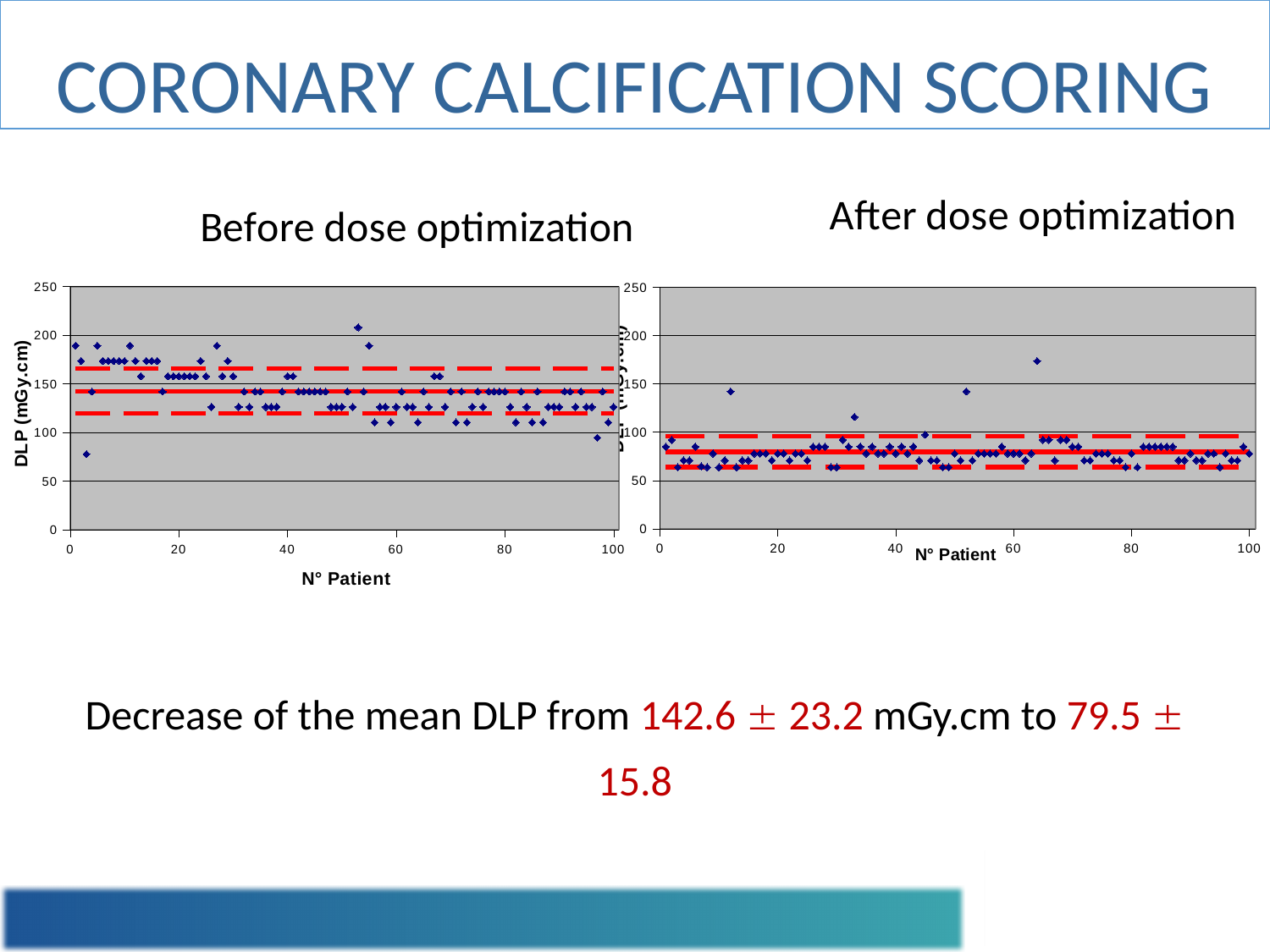
In the 'Before dose optimization' chart, is the lowest plotted point greater or less than 100? less What kind of chart is the 'After dose optimization' chart? Scatter chart What is the x-axis label on the 'After dose optimization' chart? N° Patient What is the maximum value shown on the y-axis of the 'Before dose optimization' chart? 250 In the 'After dose optimization' chart, is the highest plotted point greater or less than 150? greater In the 'Before dose optimization' chart, is the highest plotted point greater or less than 200? greater Which chart shows the higher mean DLP, 'Before dose optimization' or 'After dose optimization'? Before dose optimization What is the y-axis label on the 'Before dose optimization' chart? DLP (mGy.cm) According to the slide, what was the mean DLP after dose optimization? 79.5 ± 15.8 mGy.cm According to the slide, what was the mean DLP before dose optimization? 142.6 ± 23.2 mGy.cm What kind of chart is the 'Before dose optimization' chart? Scatter chart